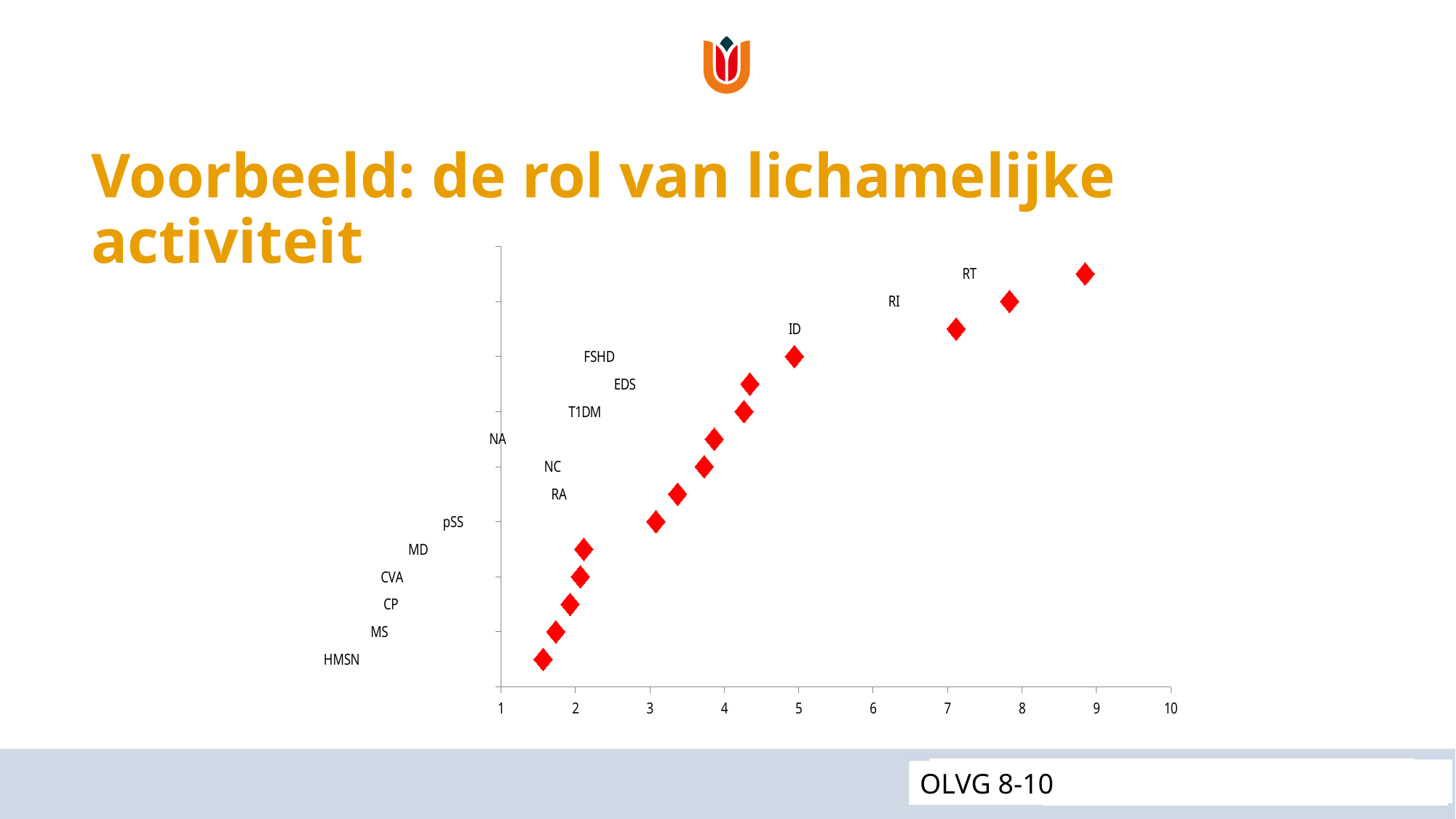
What kind of chart is shown on the slide? scatter chart How many data points are plotted in the chart? 15 What colour are the markers in the chart? red Is the x value of the rightmost point greater or less than 8? greater Do the plotted values rise or fall as the x value increases? rise Is the x value of the leftmost point greater or less than 2? less How many points have an x value less than 3? 5 What is the highest value shown on the x axis? 10 Which label appears at the top right of the chart, nearest the highest point? RT Which label appears at the bottom left of the chart, nearest the lowest point? HMSN How many points have an x value greater than 6? 3